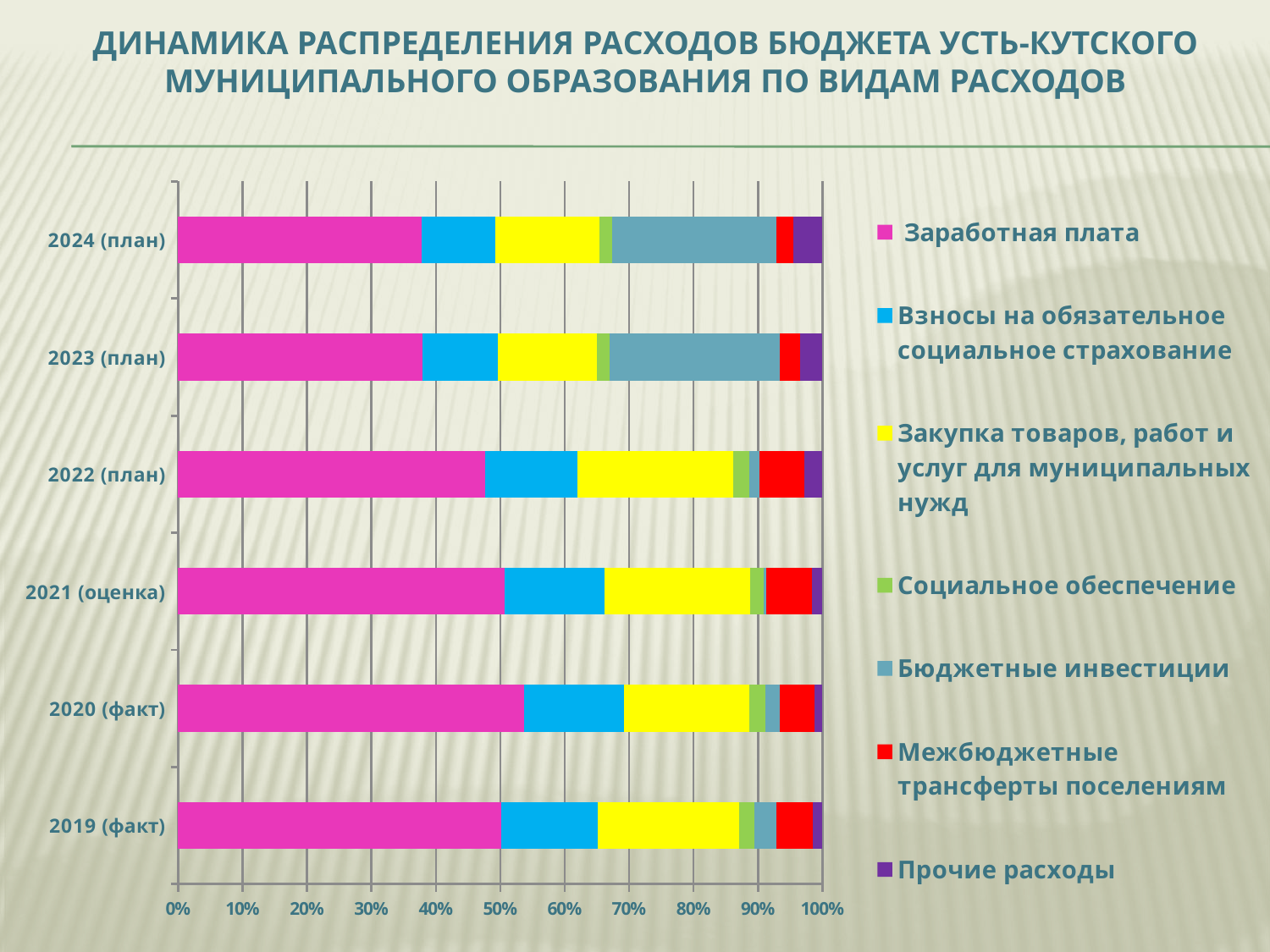
Which has the larger share of Закупка товаров, работ и услуг для муниципальных нужд: 2022 (план) or 2024 (план)? 2022 (план) Which has the larger share of Заработная плата: 2020 (факт) or 2024 (план)? 2020 (факт) Which has the larger share of Бюджетные инвестиции: 2024 (план) or 2019 (факт)? 2024 (план) Which year has the largest share of Заработная плата? 2020 (факт) How many series does the legend list? 7 What is the highest value shown on the horizontal axis? 100% Is the share of Заработная плата for 2022 (план) greater or less than 50%? less Is the share of Заработная плата for 2020 (факт) greater or less than 50%? greater How many years (categories) are shown on the vertical axis of the chart? 6 What kind of chart is shown on the slide? Stacked bar chart What is the first series listed in the legend? Заработная плата Is the share of Заработная плата for 2024 (план) greater or less than 40%? less